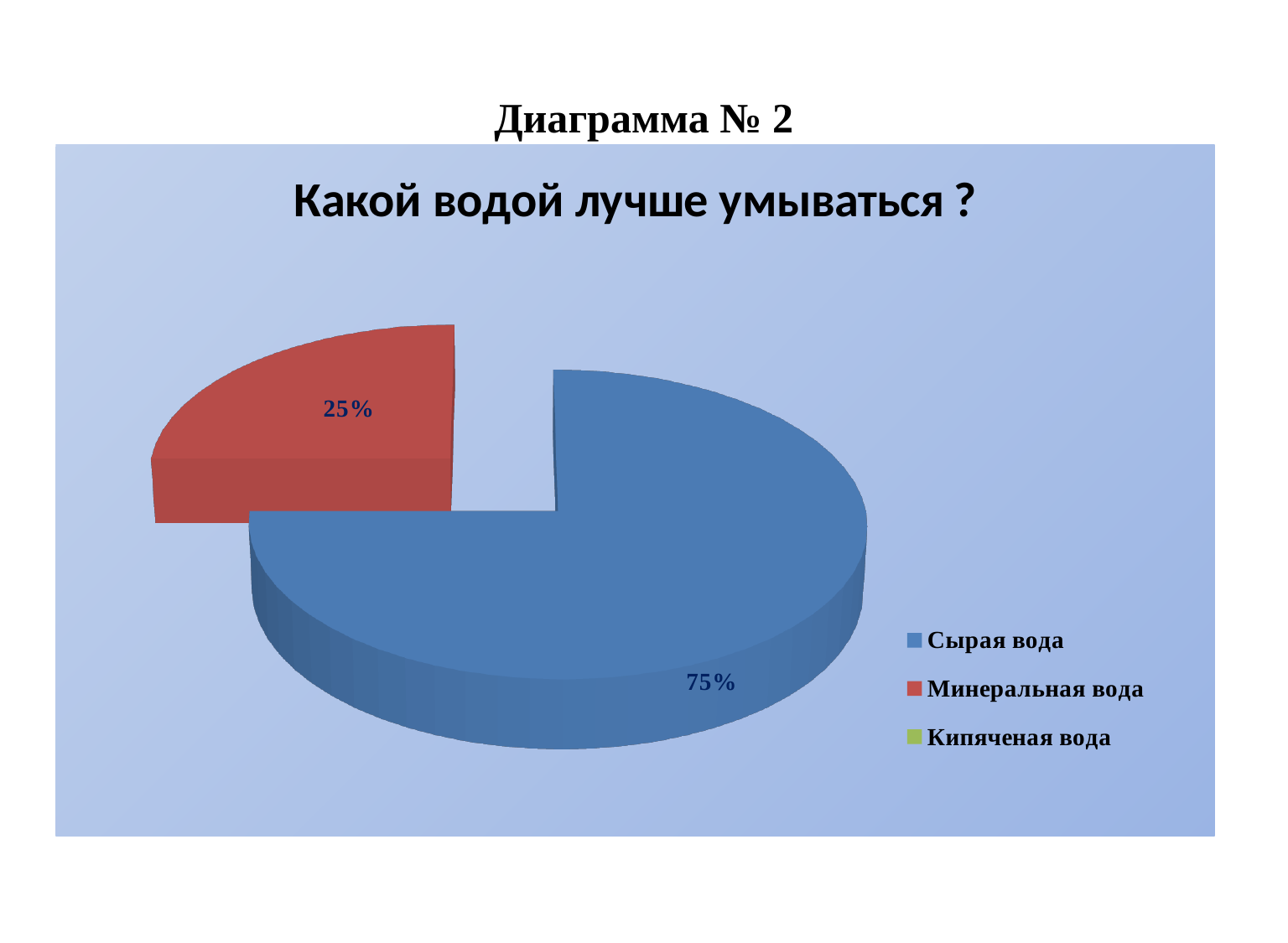
What is the difference between the shares of Сырая вода and Минеральная вода? 50% Which is larger, the share for Сырая вода or the share for Минеральная вода? Сырая вода What share of the pie does Сырая вода have? 75% What is the title of the chart? Какой водой лучше умываться ? What kind of chart is shown on the slide? pie chart How many slices are visible in the pie? 2 What share of the pie does Минеральная вода have? 25% What colour is the slice for Минеральная вода? red Is the share for Минеральная вода greater or less than 50%? less Which category has the largest share of the pie? Сырая вода How many entries does the legend list? 3